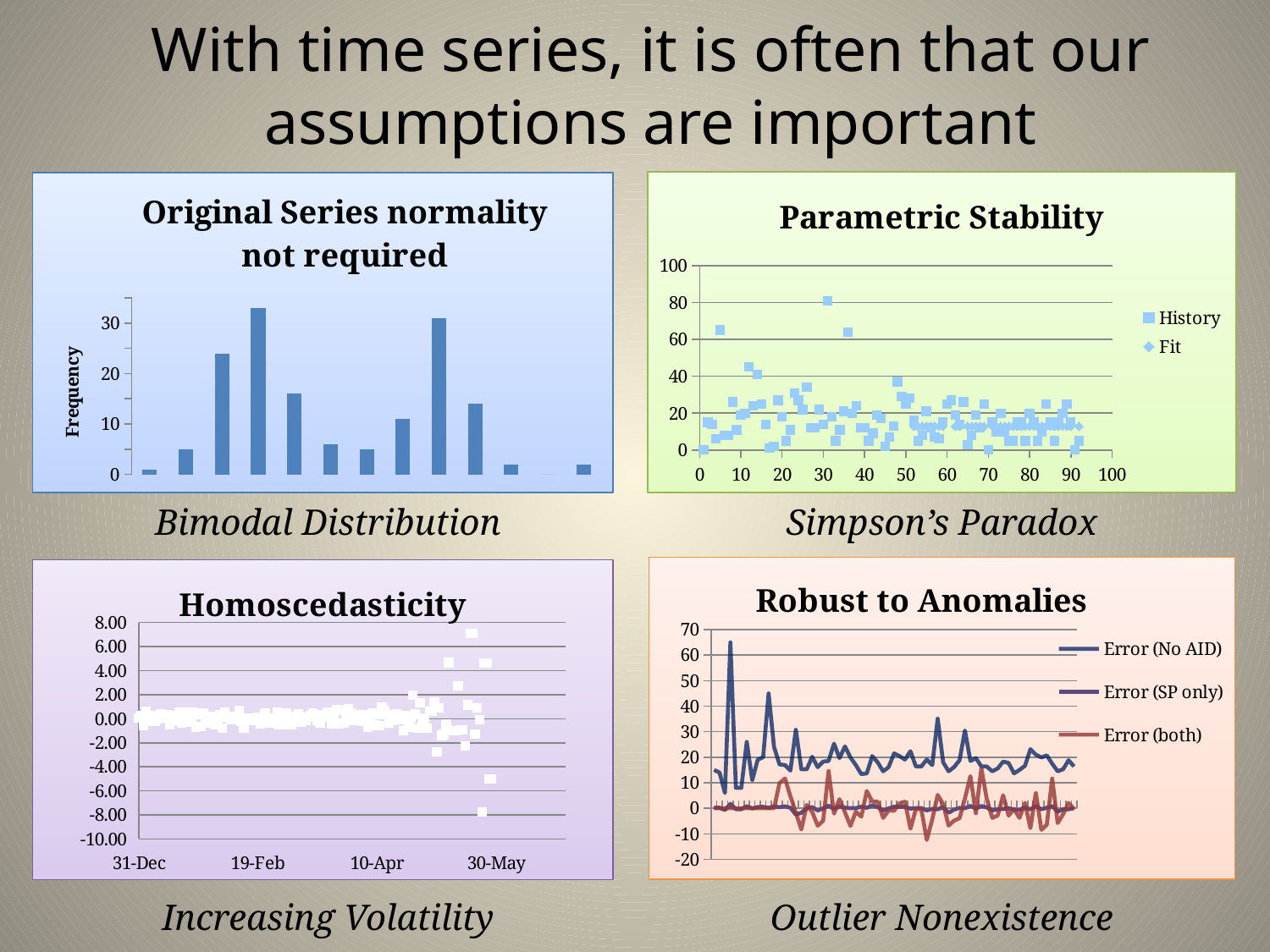
What kind of chart is the 'Robust to Anomalies' chart? line chart How many series does the legend of the 'Parametric Stability' chart list? 2 What kind of chart is the 'Original Series normality not required' chart? bar chart In the 'Original Series normality not required' chart, what is the label on the vertical axis? Frequency What kind of chart is the 'Homoscedasticity' chart? scatter chart In the 'Original Series normality not required' chart, is the tallest bar greater or less than 30? greater In the 'Parametric Stability' chart, is the highest History value greater or less than 60? greater In the 'Robust to Anomalies' chart, which series reaches the highest peak? Error (No AID) In the 'Homoscedasticity' chart, does the spread of the points increase or decrease along the x axis? increase In the 'Homoscedasticity' chart, is the highest plotted value greater or less than 6.00? greater How many series does the legend of the 'Robust to Anomalies' chart list? 3